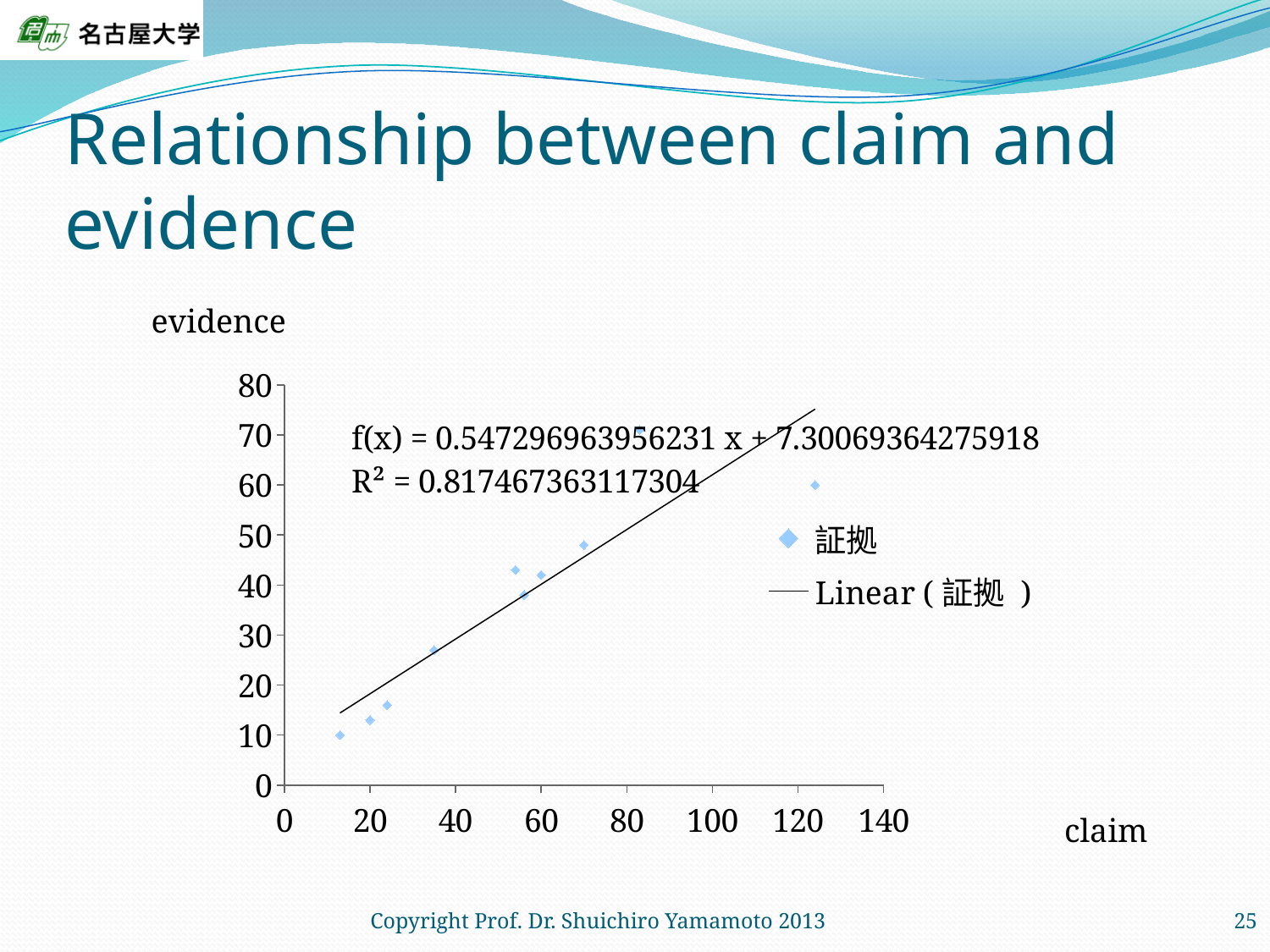
Do the evidence values generally rise or fall as claim increases along the x axis? rise Is the evidence value for the point with the smallest claim (around 12) greater or less than 20? less What is the title of the slide containing the chart? Relationship between claim and evidence What is the intercept of the linear trendline shown on the chart? 7.30069364275918 Is the evidence value for the point with the largest claim (around 120) greater or less than 50? greater What is the trendline equation printed on the chart? f(x) = 0.547296963956231 x + 7.30069364275918 What is the highest tick value shown on the vertical (evidence) axis? 80 What label is given to the horizontal axis of the chart? claim What is the R² value printed on the chart? 0.817467363117304 What kind of chart is shown on the slide? scatter chart How many entries does the chart legend list? 2 What is the slope of the linear trendline shown on the chart? 0.547296963956231